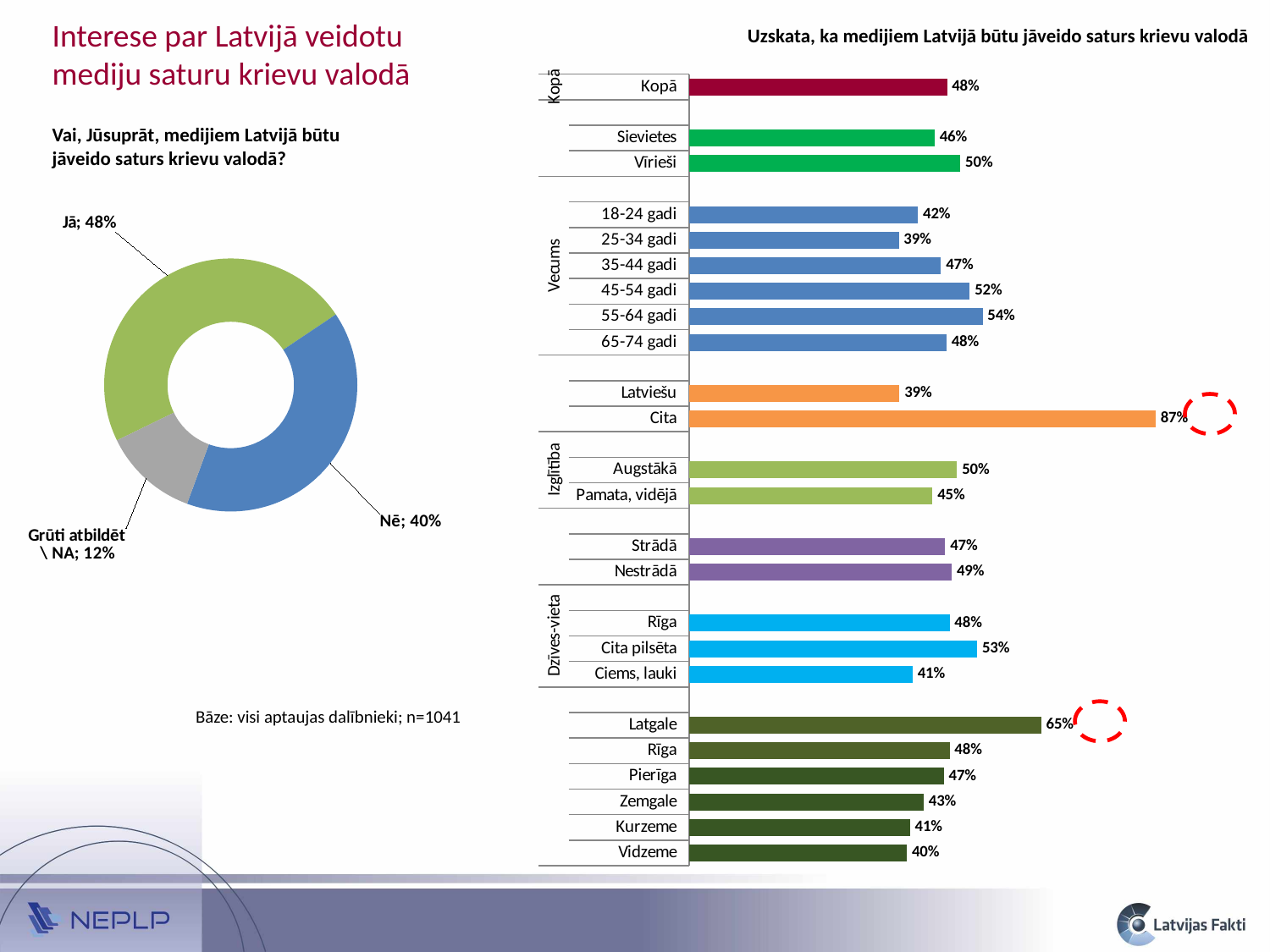
In the bar chart on the right, how many age groups are shown under "Vecums"? 6 In the donut chart on the left, how many percentage points larger is the "Jā" share than the "Nē" share? 8 In the bar chart on the right, which is larger: the value for "Sievietes" or for "Vīrieši"? Vīrieši In the donut chart on the left, what share of respondents answered "Grūti atbildēt \ NA"? 12% In the bar chart on the right, which category has the highest value? Cita In the bar chart on the right, what is the value for "Cita" (ethnicity)? 87% In the bar chart on the right, what is the difference between the values for "Latgale" and "Vidzeme"? 25 percentage points In the donut chart on the left, which answer has the smallest share? Grūti atbildēt \ NA What kind of chart is the chart on the right side of the slide? Bar chart In the donut chart on the left, what share of respondents answered "Jā"? 48% What is the title of the bar chart on the right? Uzskata, ka medijiem Latvijā būtu jāveido saturs krievu valodā In the bar chart on the right, which age group (Vecums) has the lowest value? 25-34 gadi